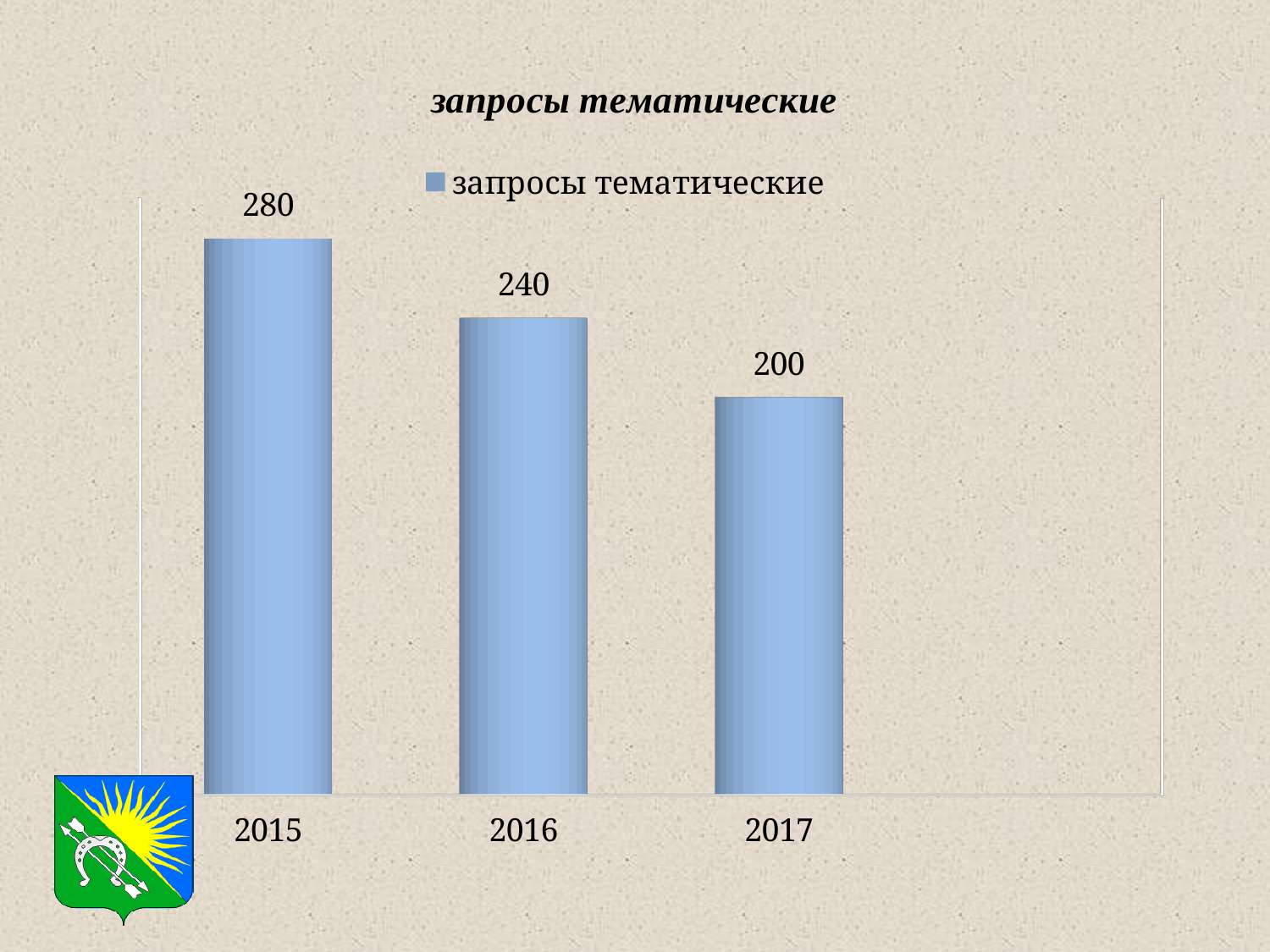
What is the value for 2015? 280 Which year has the lowest value? 2017 Which is larger, the value for 2016 or the value for 2017? 2016 What kind of chart is this? bar chart What is the value for 2017? 200 What is the difference between the values for 2015 and 2017? 80 Do the values rise or fall from 2015 to 2017? fall How many years are shown on the x axis? 3 How many series does the legend list? 1 Which year has the highest value? 2015 What is the difference between the values for 2015 and 2016? 40 What is the value for 2016? 240